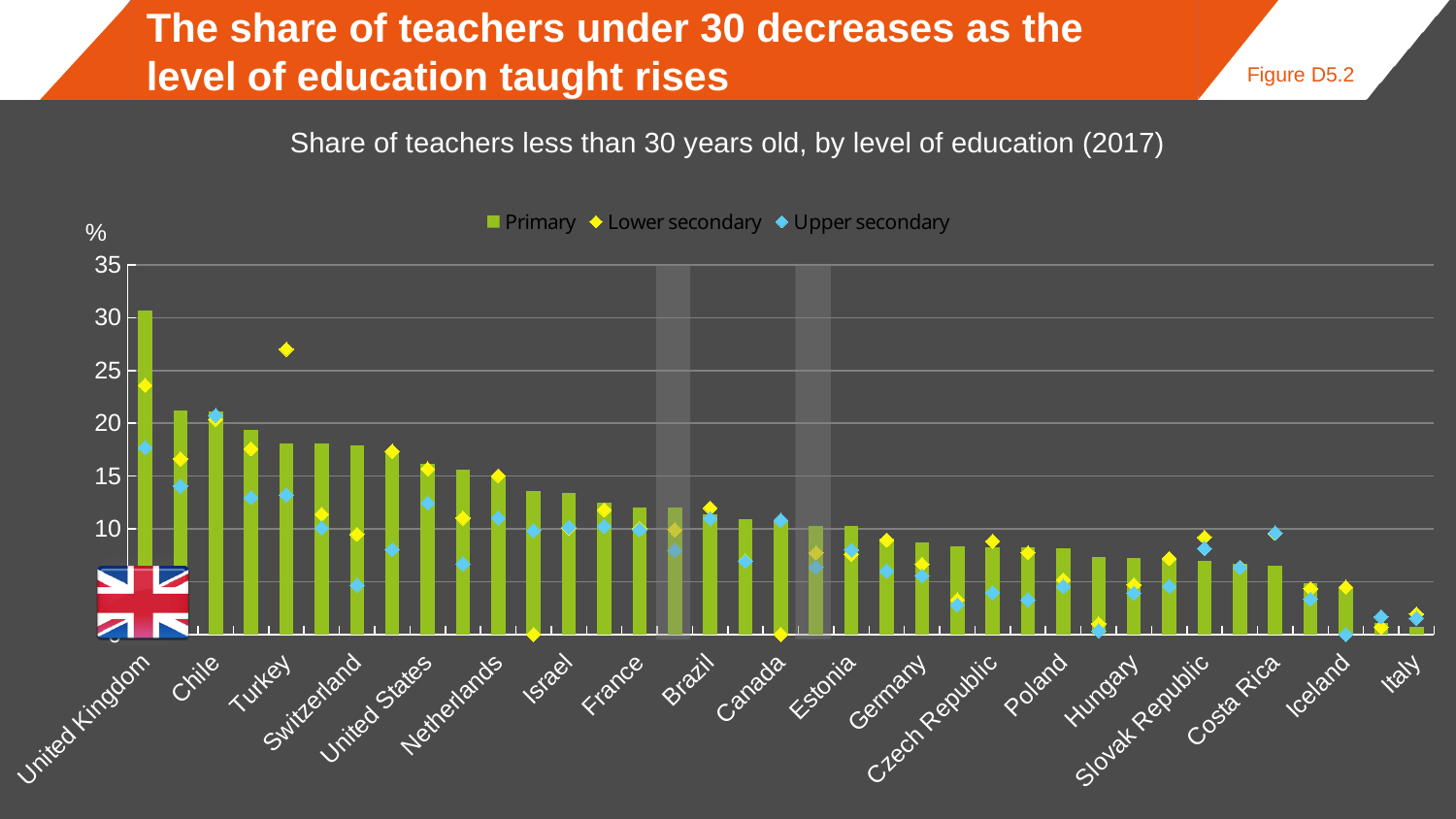
Which country has the lowest Primary value? Italy Do the Primary values rise or fall from left to right along the x axis? fall How many series does the legend list? 3 Which country has the highest Primary value? United Kingdom Is the Lower secondary value for Turkey greater or less than 25? greater For Turkey, which is larger, the Primary value or the Lower secondary value? Lower secondary Is the Primary value for Germany greater or less than 10? less What kind of chart is shown on the slide? bar chart Which has the larger Primary value, United Kingdom or Chile? United Kingdom What colour are the Lower secondary markers in the legend? yellow Is the Primary value for United Kingdom greater or less than 25? greater